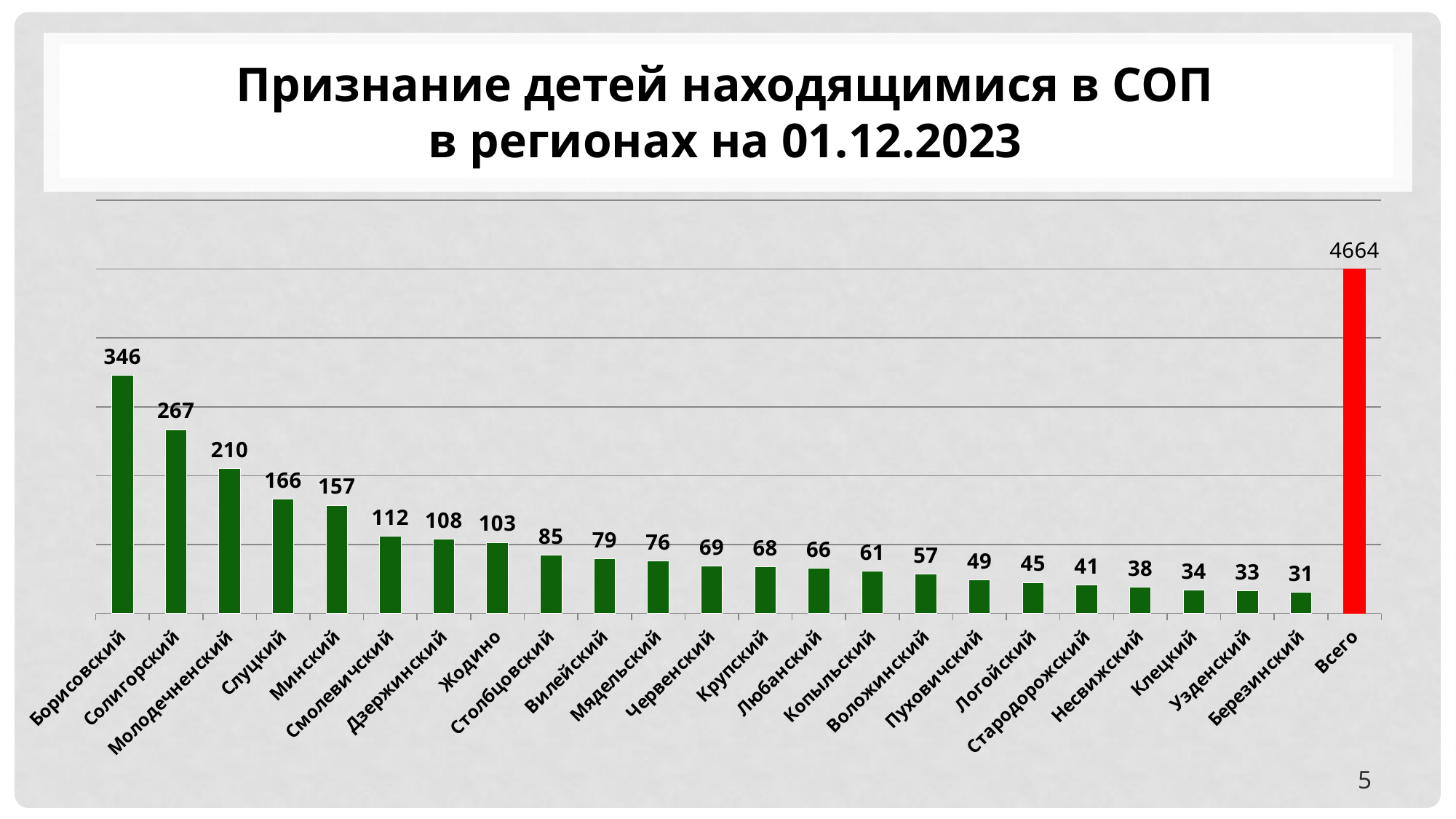
What is the difference between the values for Солигорский and Молодечненский? 57 Which category has the lowest value? Березинский What is the value for Березинский? 31 What is the value for Минский? 157 What is the value for Борисовский? 346 What colour is the bar for Всего? Red What is the value shown for Всего? 4664 Do the values for the regions rise or fall from left to right (excluding Всего)? Fall What kind of chart is shown on the slide? Bar chart Which region (excluding Всего) has the highest value? Борисовский Which is larger, the value for Жодино or the value for Столбцовский? Жодино How many bars are shown on the chart, including Всего? 24